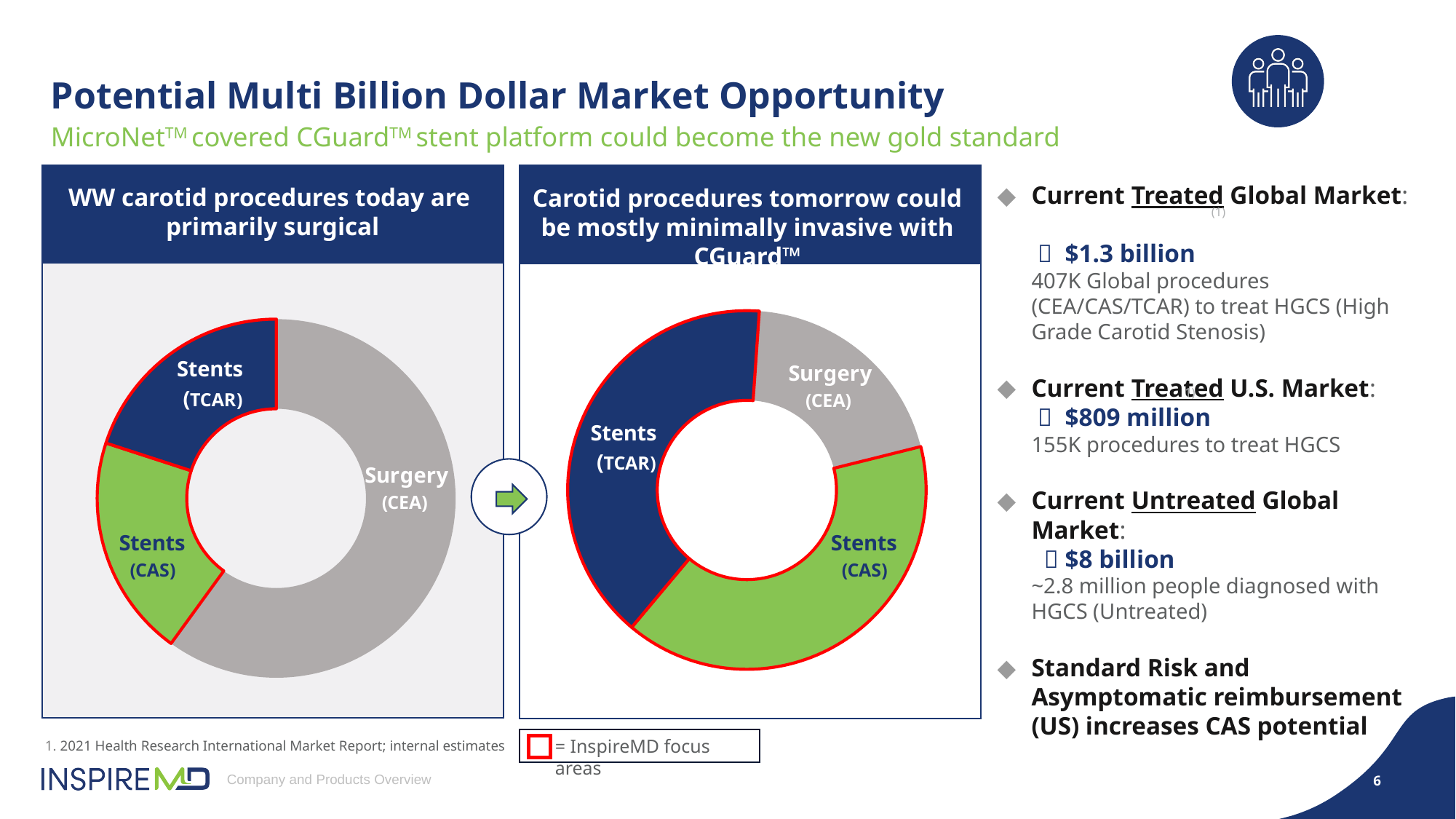
What colour is the Surgery (CEA) segment in both donut charts? Grey What kind of chart is shown in the left panel titled 'WW carotid procedures today are primarily surgical'? Pie (donut) chart According to the legend below the charts, what do the red outlines on the segments indicate? InspireMD focus areas In the right chart ('Carotid procedures tomorrow could be mostly minimally invasive with CGuard'), which category has the largest share? Stents (CAS) and Stents (TCAR) are tied (equal shares) How many categories does the right chart ('Carotid procedures tomorrow could be mostly minimally invasive with CGuard') show? 3 In the left chart ('WW carotid procedures today are primarily surgical'), which is larger: Surgery (CEA) or Stents (CAS)? Surgery (CEA) In the right chart ('Carotid procedures tomorrow could be mostly minimally invasive with CGuard'), which category has the smallest share? Surgery (CEA) In the right chart ('Carotid procedures tomorrow could be mostly minimally invasive with CGuard'), which is larger: Stents (CAS) or Surgery (CEA)? Stents (CAS) How many categories does the left chart ('WW carotid procedures today are primarily surgical') show? 3 In the right chart ('Carotid procedures tomorrow could be mostly minimally invasive with CGuard'), which is larger: Stents (TCAR) or Surgery (CEA)? Stents (TCAR) In the left chart ('WW carotid procedures today are primarily surgical'), which category has the largest share? Surgery (CEA)